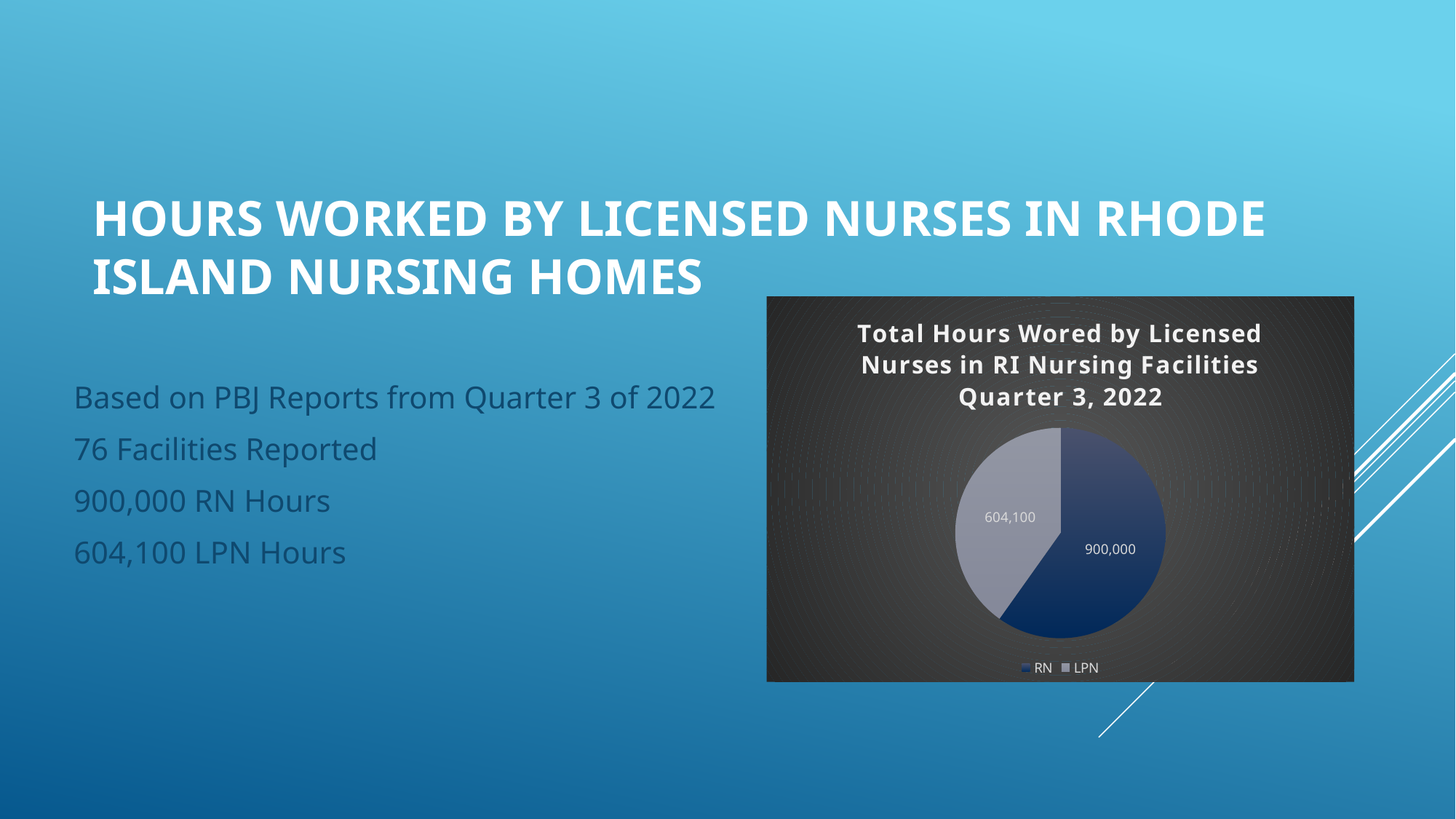
What is the difference between the RN hours and the LPN hours in the pie chart? 295,900 What share of the pie chart does the RN slice represent, to one decimal place? 59.8% Which is larger in the pie chart, RN hours or LPN hours? RN How many entries does the pie chart legend list? 2 Which category has the smallest slice in the pie chart? LPN What type of chart is shown on the slide? pie chart What is the title of the pie chart? Total Hours Wored by Licensed Nurses in RI Nursing Facilities Quarter 3, 2022 What is the total of the two slices in the pie chart? 1,504,100 How many slices does the pie chart have? 2 How many hours are shown for RN in the pie chart? 900,000 Which category has the largest slice in the pie chart? RN How many hours are shown for LPN in the pie chart? 604,100